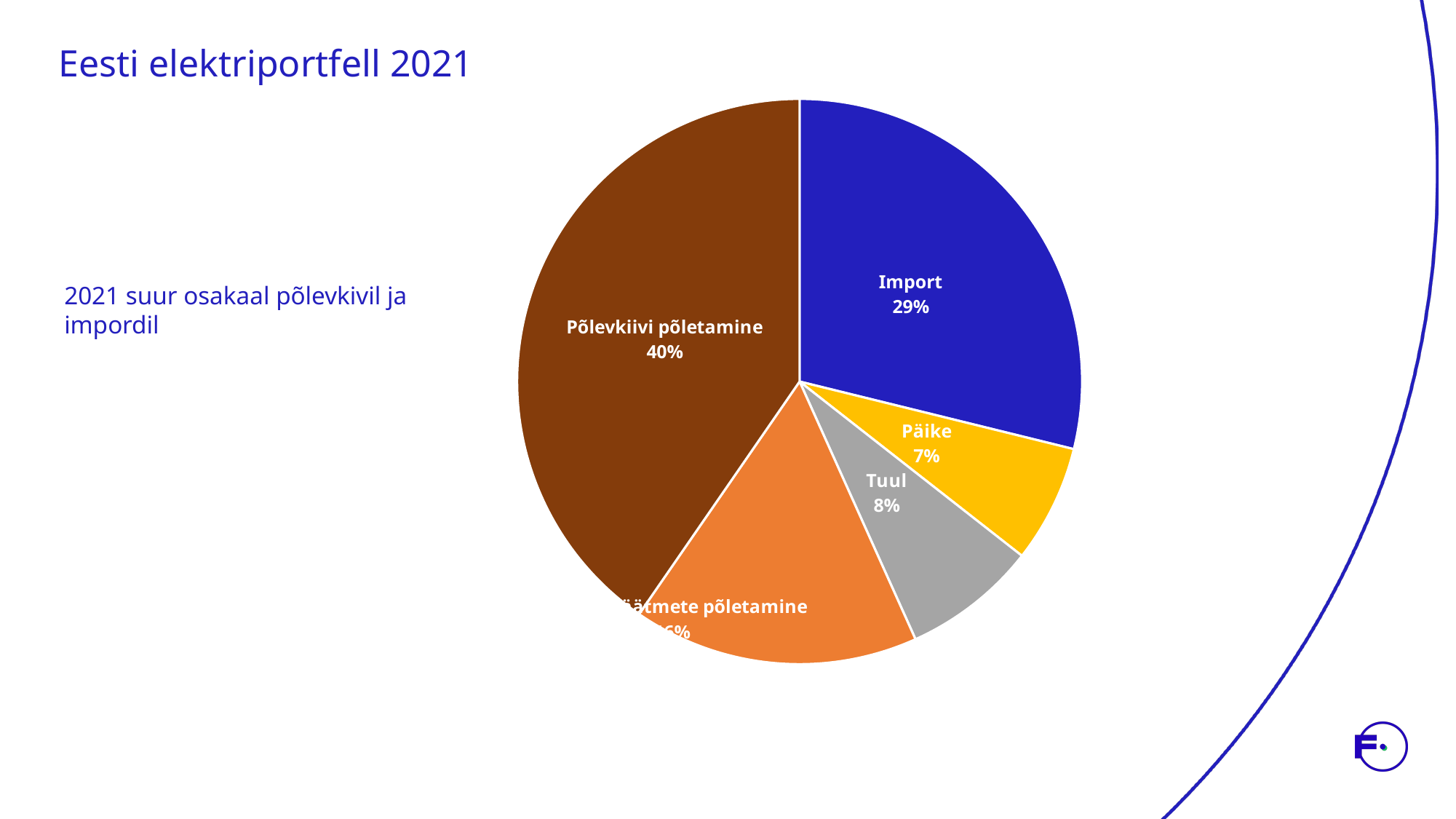
What share of the pie does Tuul have? 8% What share of the pie does Põlevkiivi põletamine have? 40% Which category has the smallest slice of the pie? Päike What share of the pie does Import have? 29% What is the difference in percentage points between Põlevkiivi põletamine and Import? 11 Which category has the largest slice of the pie? Põlevkiivi põletamine How many slices does the pie chart have? 5 What is the title of the slide's chart? Eesti elektriportfell 2021 Which is larger, the share for Tuul or the share for Päike? Tuul What colour is the Import slice? blue What kind of chart is shown on the slide? pie chart What share of the pie does Päike have? 7%